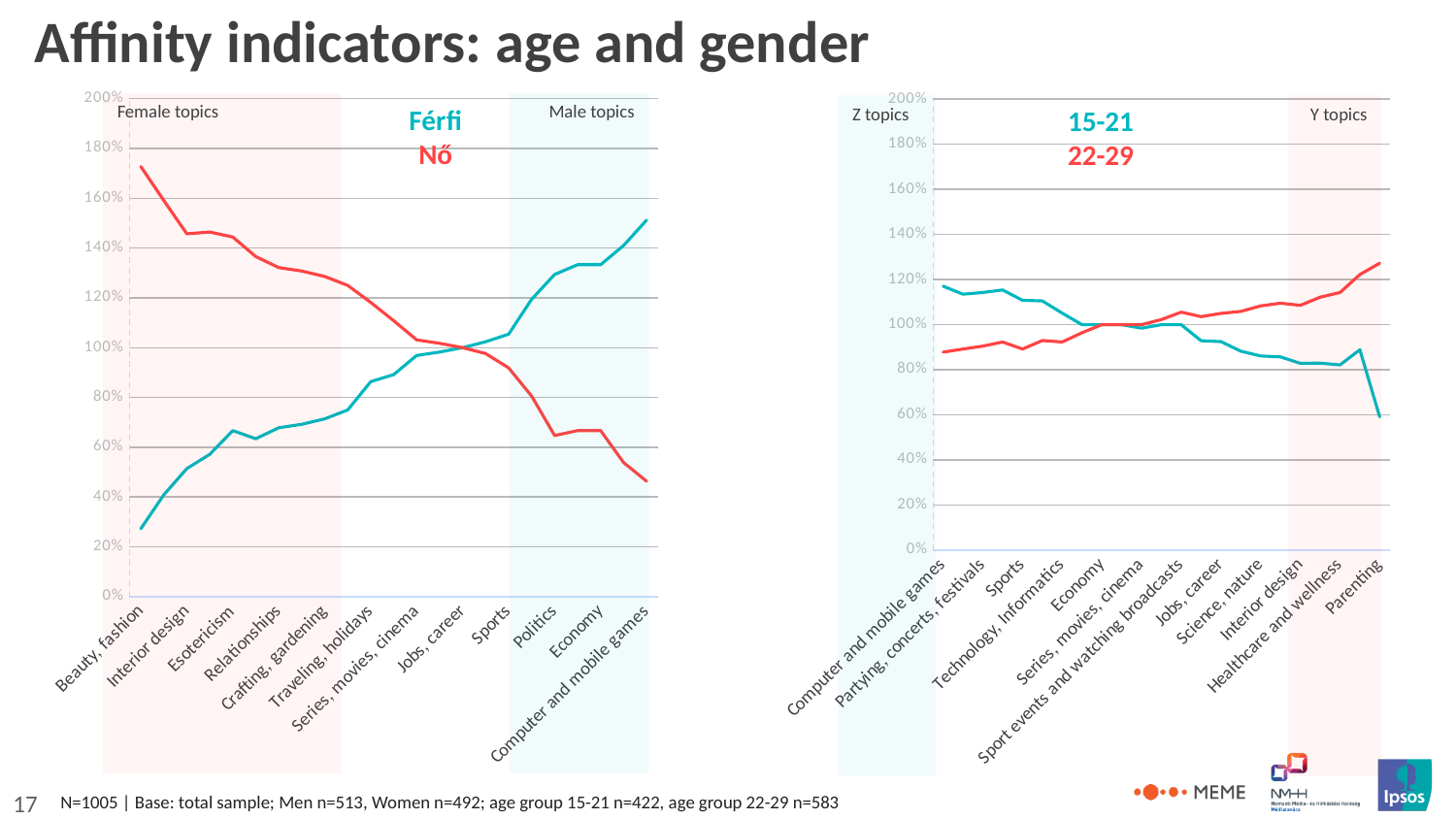
In the right chart, is the 15-21 value for Parenting greater or less than 80%? less In the right chart, which series has the larger value for Computer and mobile games, 15-21 or 22-29? 15-21 In the left chart, which category has the highest Férfi value? Computer and mobile games In the left chart, does the Nő line generally rise or fall from left to right along the x axis? fall In the right chart, does the 22-29 line generally rise or fall from left to right along the x axis? rise In the left chart, is the Férfi value for Beauty, fashion greater or less than 40%? less In the left chart, is the Nő value for Beauty, fashion greater or less than 160%? greater What kind of chart is the left chart (Férfi / Nő)? line chart How many series does the legend of the left chart list? 2 In the left chart, which category has the lowest Nő value? Computer and mobile games